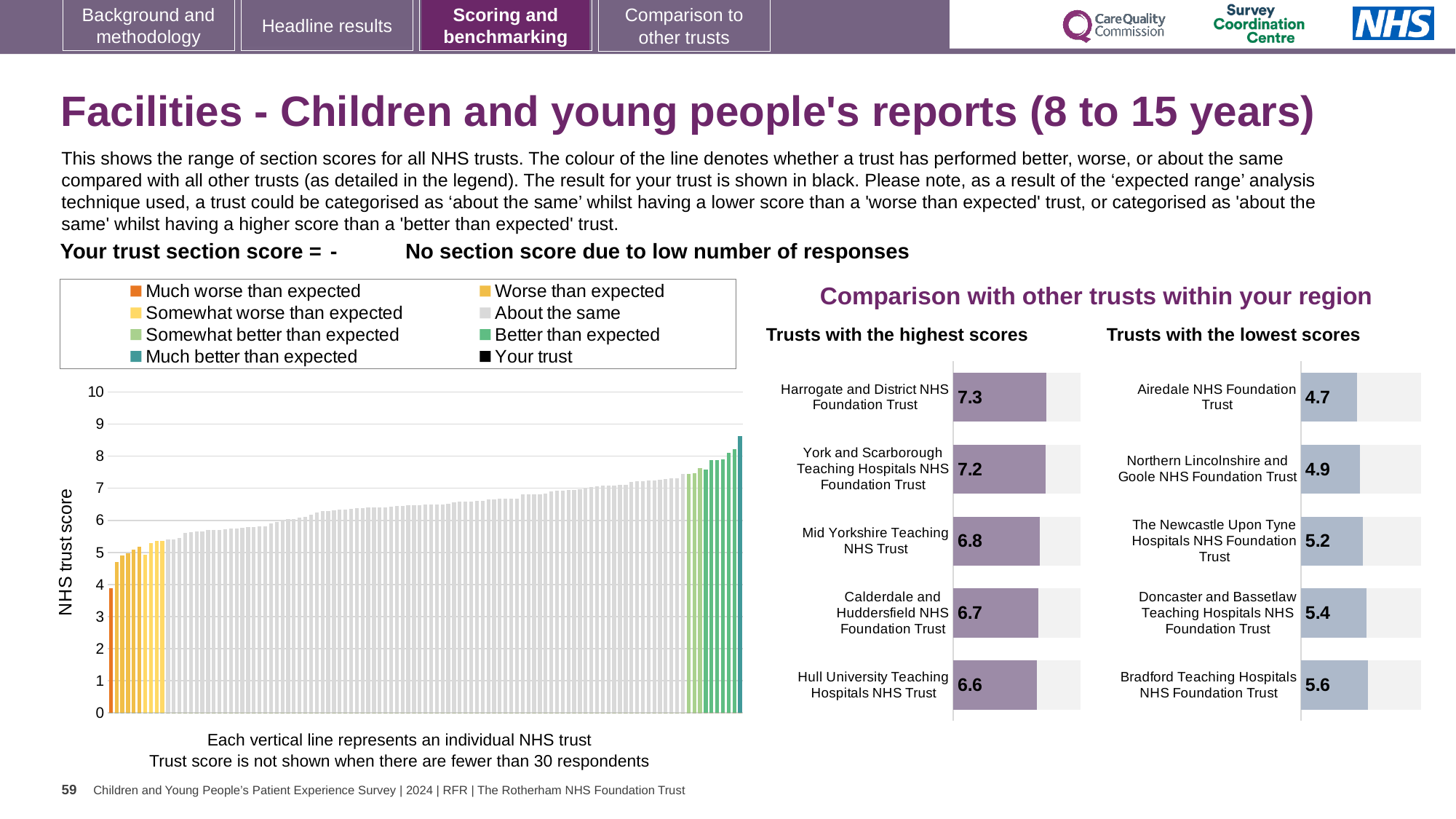
In the large chart on the left showing the range of section scores, is the value of the tallest bar greater or less than 8? greater In the 'Trusts with the lowest scores' chart, what is the score for Bradford Teaching Hospitals NHS Foundation Trust? 5.6 In the 'Trusts with the highest scores' chart, what is the score for Harrogate and District NHS Foundation Trust? 7.3 In the 'Trusts with the highest scores' chart, what is the score for Mid Yorkshire Teaching NHS Trust? 6.8 How many trusts are listed in the 'Trusts with the lowest scores' chart? 5 In the 'Trusts with the lowest scores' chart, what is the score for Airedale NHS Foundation Trust? 4.7 In the 'Trusts with the lowest scores' chart, which has the larger score: The Newcastle Upon Tyne Hospitals NHS Foundation Trust or Doncaster and Bassetlaw Teaching Hospitals NHS Foundation Trust? Doncaster and Bassetlaw Teaching Hospitals NHS Foundation Trust How many entries does the legend of the large chart on the left list? 8 In the 'Trusts with the highest scores' chart, what is the difference between the scores of Harrogate and District NHS Foundation Trust and Hull University Teaching Hospitals NHS Trust? 0.7 In the 'Trusts with the lowest scores' chart, which trust has the highest score shown? Bradford Teaching Hospitals NHS Foundation Trust In the large chart on the left, do the bar values rise or fall from left to right? rise In the 'Trusts with the highest scores' chart, which trust has the lowest score shown? Hull University Teaching Hospitals NHS Trust